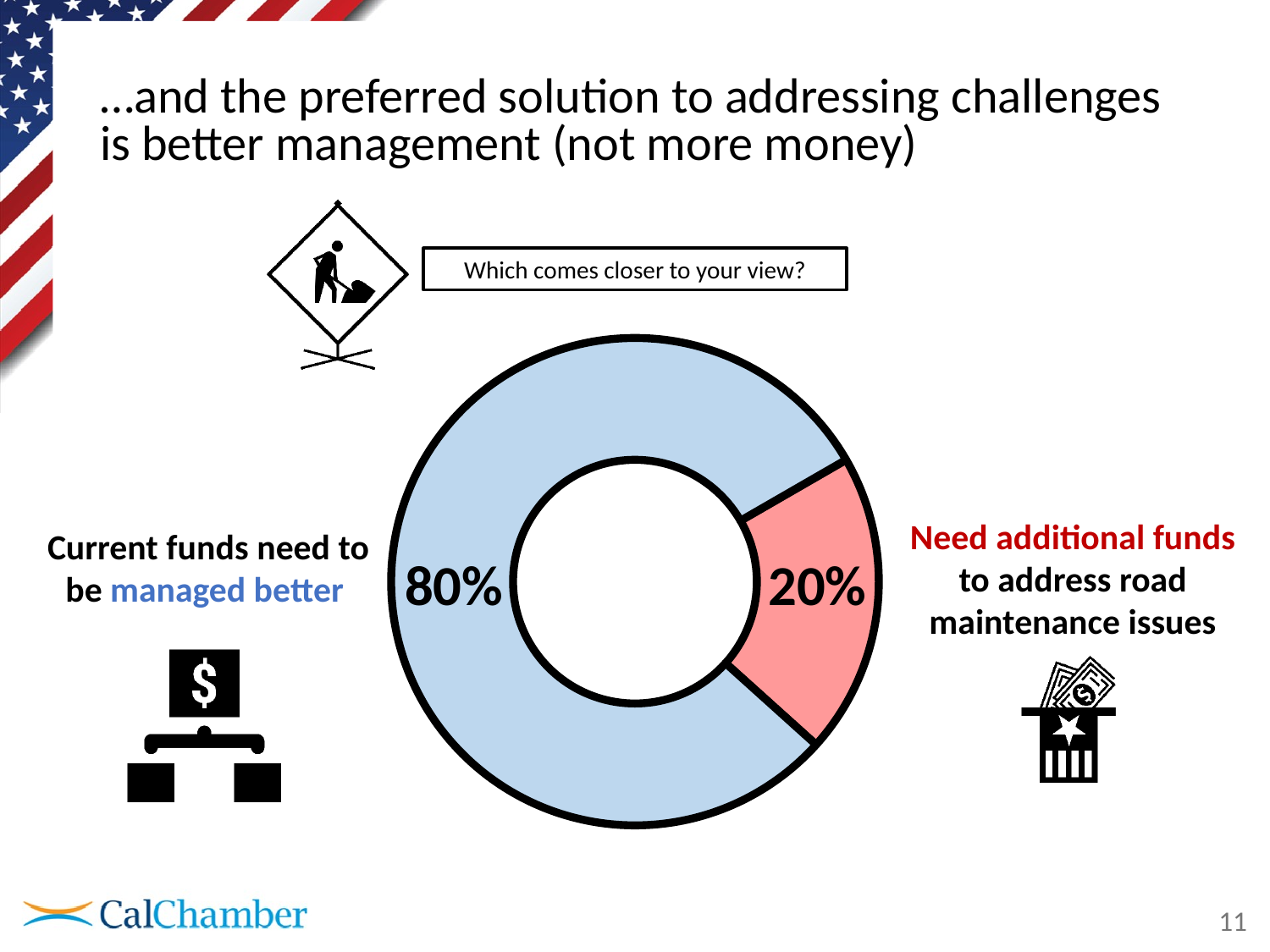
How many response categories are shown in the donut chart? 2 What is the difference in percentage points between the 'managed better' share and the 'need additional funds' share? 60 What kind of chart is shown on the slide? Donut (pie) chart Is the share for 'Need additional funds' larger or smaller than the share for 'Current funds need to be managed better'? smaller What survey question is shown in the box above the chart? Which comes closer to your view? What colour is the slice representing 'Need additional funds to address road maintenance issues'? Pink/red What is the total of the two percentages shown in the chart? 100% Which response has the larger share of the donut chart? Current funds need to be managed better Which response has the smaller share of the donut chart? Need additional funds to address road maintenance issues What percentage of respondents say additional funds are needed to address road maintenance issues? 20% What percentage of respondents say current funds need to be managed better? 80%